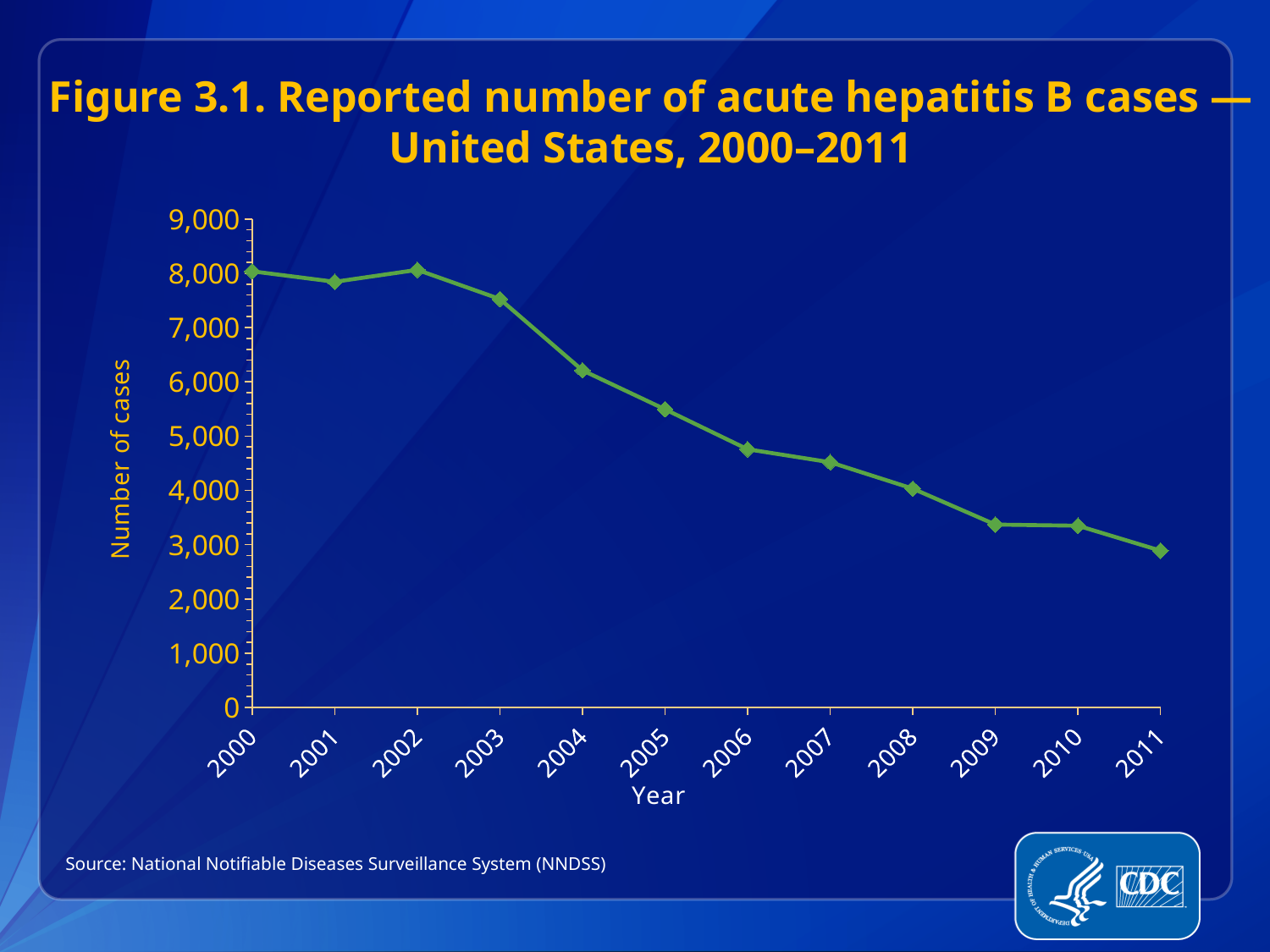
How many years (data points) are plotted on the chart? 12 Is the value for 2006 greater or less than 5,000? less Which year has the lowest reported number of acute hepatitis B cases? 2011 Is the value for 2011 greater or less than 3,000? less Which year has more reported cases, 2005 or 2008? 2005 Is the value for 2004 greater or less than 6,000? greater Overall, do the reported numbers of acute hepatitis B cases rise or fall from 2000 to 2011? Fall What kind of chart is shown on the slide? Line chart Which year has more reported cases, 2003 or 2004? 2003 What is the label on the vertical axis of the chart? Number of cases